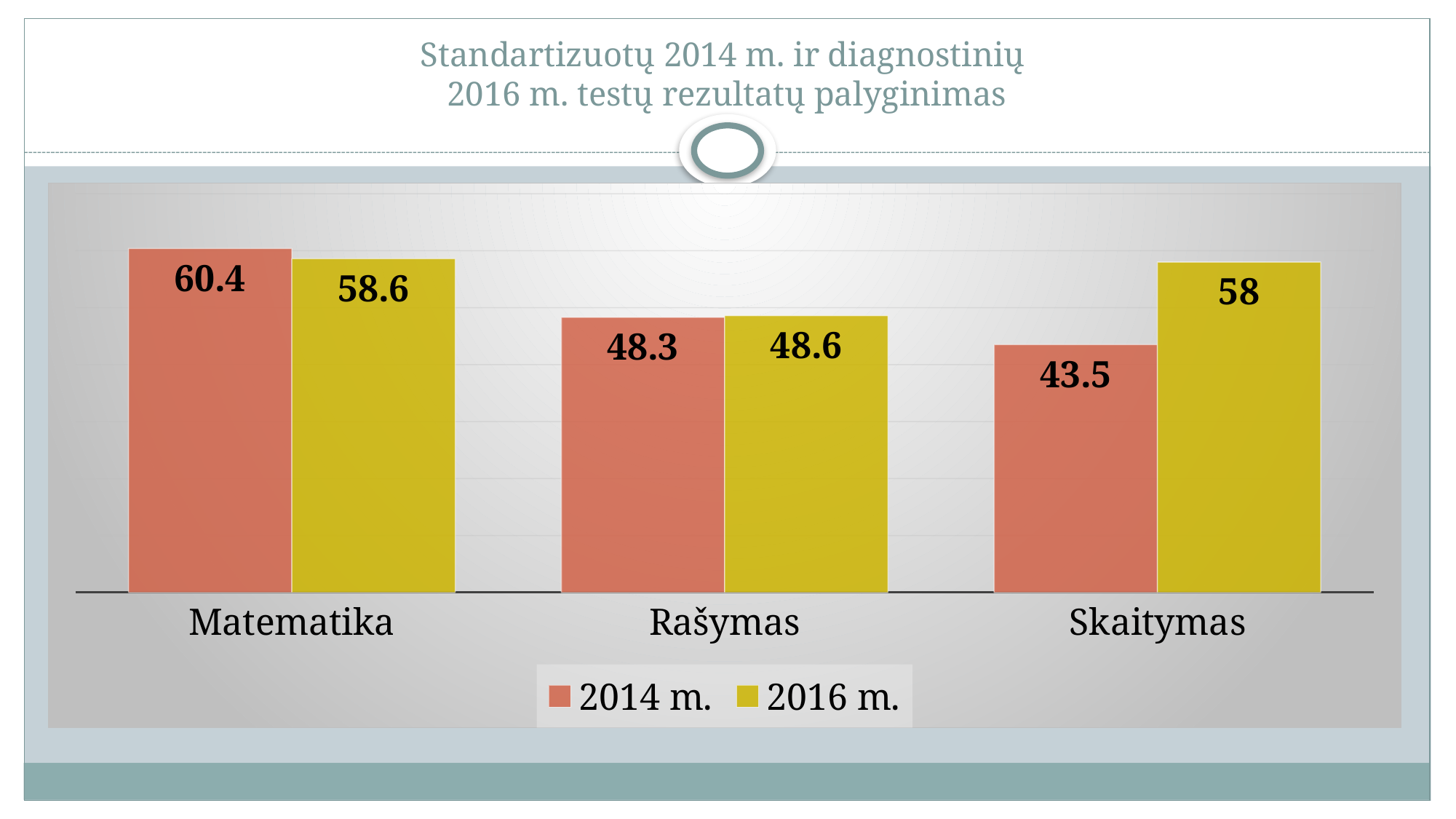
Which category has the lowest 2014 m. value? Skaitymas Which category has the lowest 2016 m. value? Rašymas How many series does the legend list? 2 What is the 2016 m. value for Matematika? 58.6 What is the 2014 m. value for Rašymas? 48.3 What is the 2016 m. value for Skaitymas? 58 Which category has the highest 2014 m. value? Matematika How many categories are shown on the x axis? 3 What is the difference between the 2016 m. and 2014 m. values for Skaitymas? 14.5 For Skaitymas, which series has the larger value, 2014 m. or 2016 m.? 2016 m. What is the difference between the 2014 m. and 2016 m. values for Matematika? 1.8 What is the 2014 m. value for Matematika? 60.4